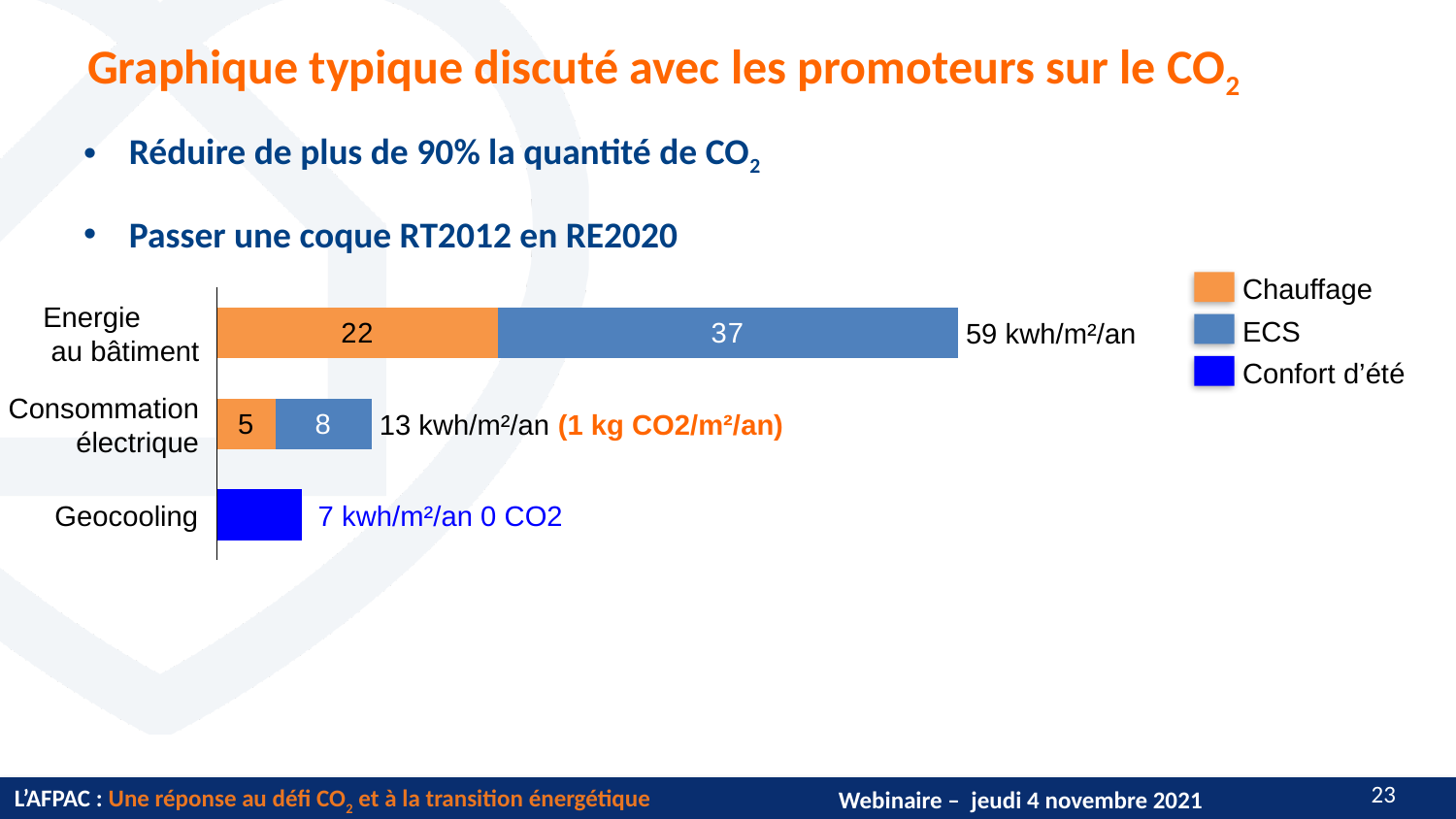
What is the Chauffage value for Consommation électrique? 5 What is the Chauffage value for Energie au bâtiment? 22 What is the ECS value for Energie au bâtiment? 37 What is the total shown for the Consommation électrique bar? 13 kwh/m²/an What is the total shown for the Energie au bâtiment bar? 59 kwh/m²/an How many series does the legend list? 3 What is the difference between the ECS and Chauffage values for Energie au bâtiment? 15 Which category has the longest bar? Energie au bâtiment What is the ECS value for Consommation électrique? 8 Which is larger for Consommation électrique, Chauffage or ECS? ECS What value is shown for Geocooling? 7 kwh/m²/an What kind of chart is shown? Stacked bar chart